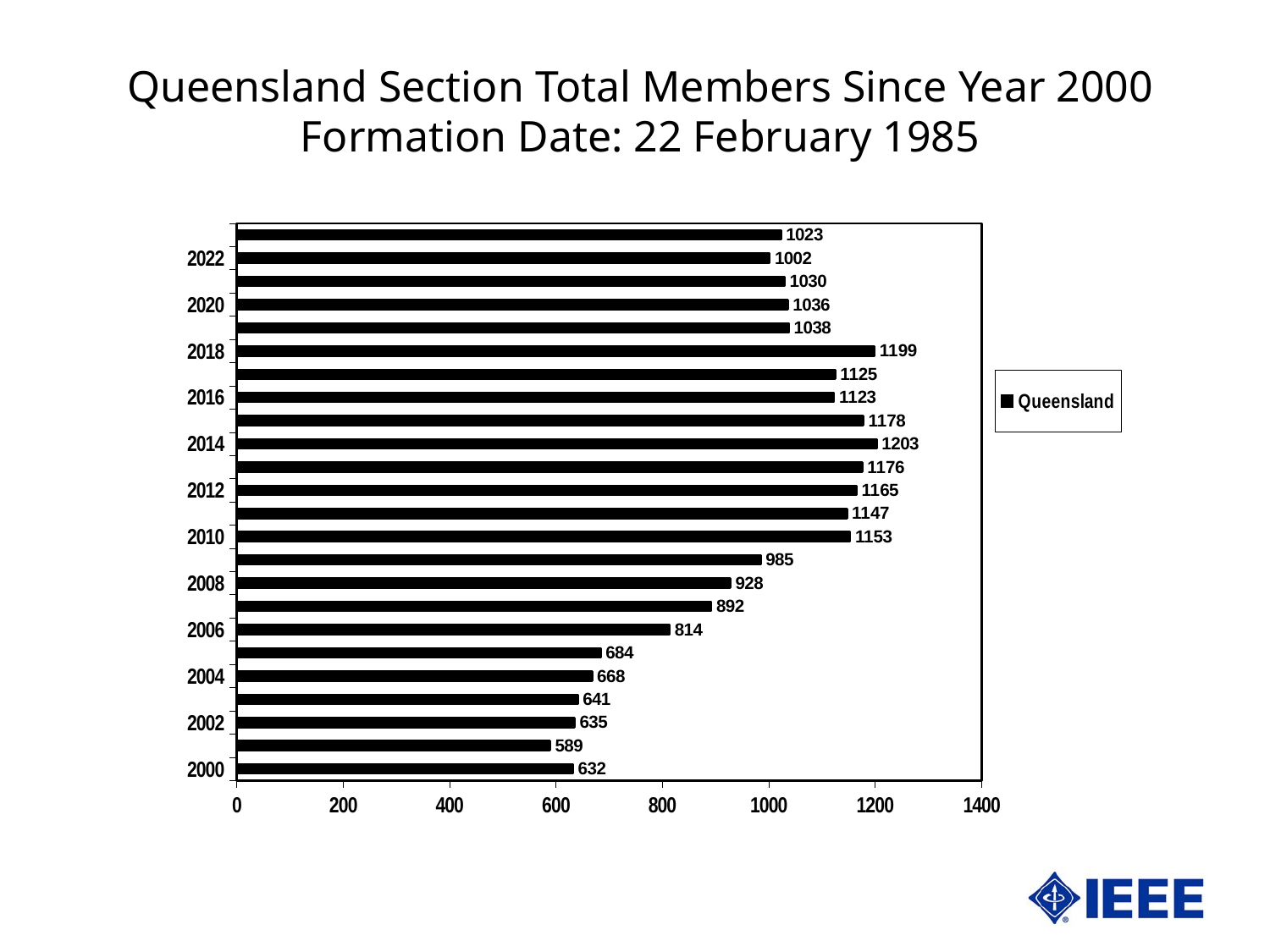
Which is larger, the value for 2006 or the value for 2010? 2010 What is the smallest value labeled on any bar in the chart? 589 What is the difference between the values for 2018 and 2020? 163 What is the value for 2008? 928 What is the value for 2000? 632 How many bars are plotted in the chart? 24 What is the value for 2014? 1203 Is the value for 2004 greater or less than 800? less What is the value for 2022? 1002 What type of chart is shown on the slide? bar chart Which year has the highest value? 2014 How many series does the legend list? 1